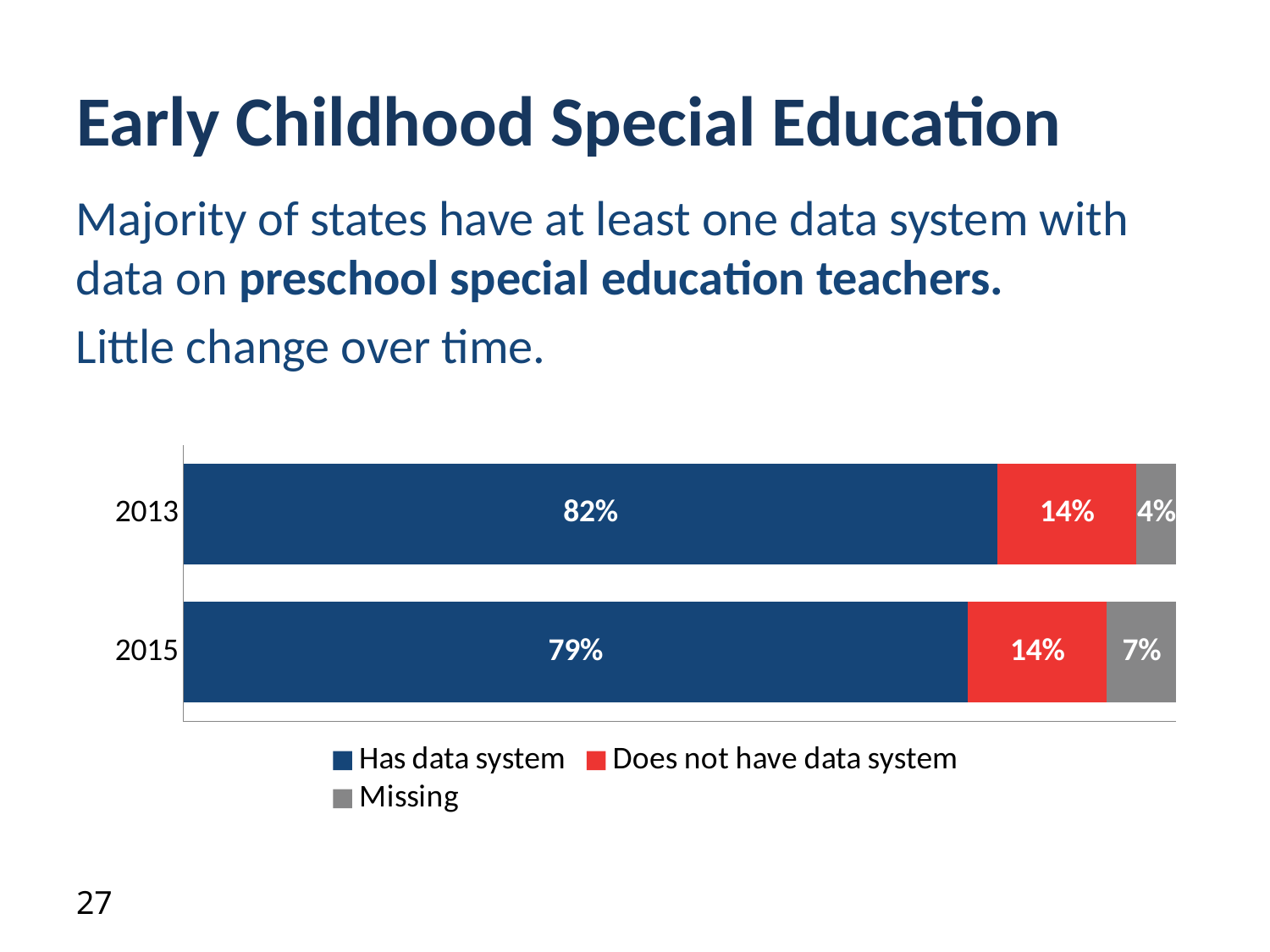
What is the difference between the Missing values for 2015 and 2013? 3% How many series does the legend list? 3 What is the Does not have data system value for 2013? 14% What percentage of states had a data system in 2015? 79% What is the Missing value for 2015? 7% Which year has the higher Missing value? 2015 Which year has the higher Has data system value? 2013 What percentage of states had a data system in 2013? 82% How many years are shown on the chart? 2 What is the difference between the Has data system values for 2013 and 2015? 3% Which colour represents Does not have data system in the chart? Red What kind of chart is shown on the slide? Stacked bar chart